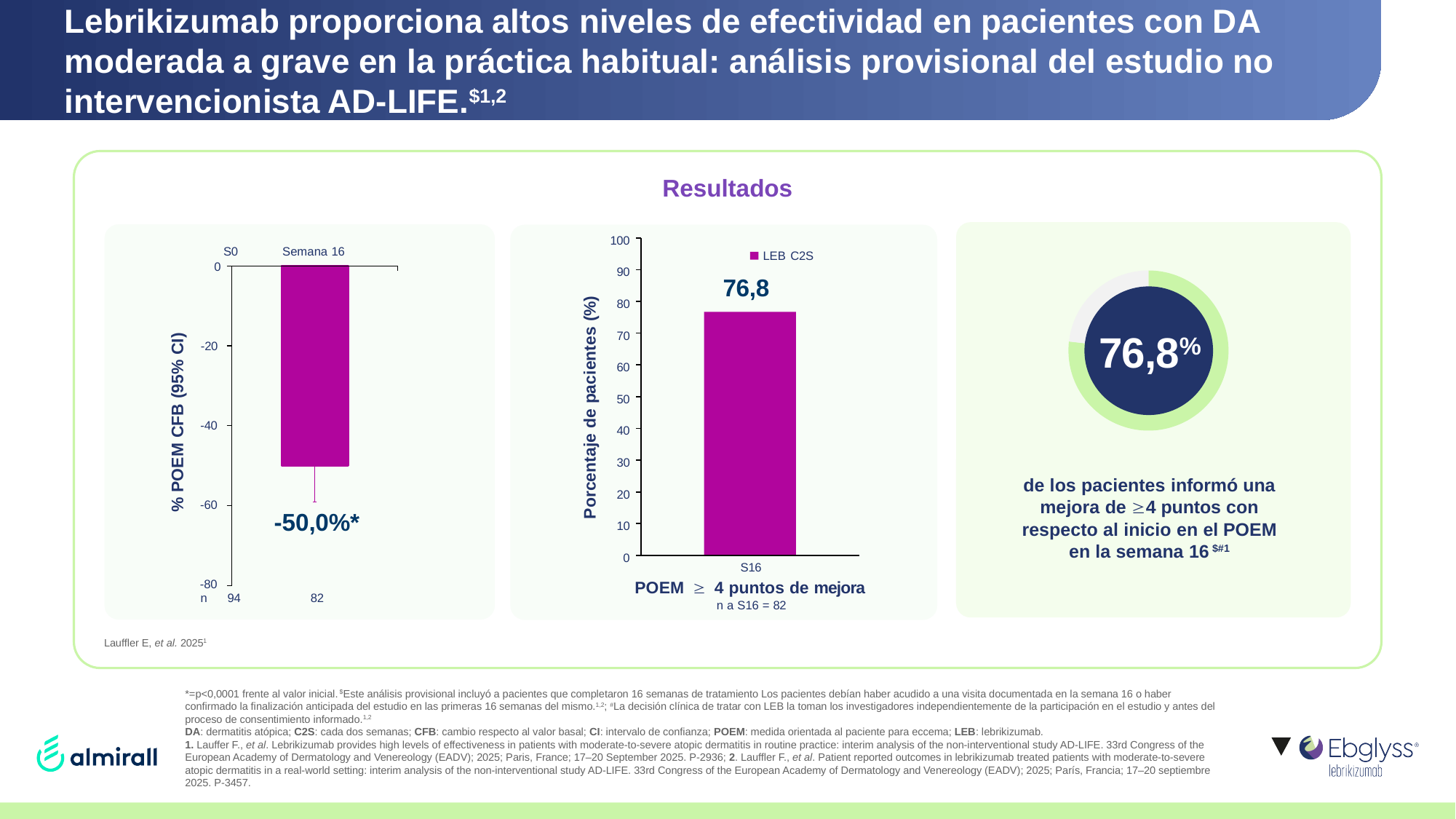
How many series does the legend of the right chart (Porcentaje de pacientes) list? 1 In the left chart (% POEM CFB), what is the value shown for Semana 16? -50,0% What is the legend entry in the right chart (Porcentaje de pacientes)? LEB C2S In the left chart (% POEM CFB), what is the n value shown under S0? 94 What kind of chart is the right chart (Porcentaje de pacientes)? bar chart In the right bar chart (Porcentaje de pacientes), what is the value shown for S16? 76,8 What kind of chart is the left chart (% POEM CFB)? bar chart What is the y-axis title of the left chart? % POEM CFB (95% CI) How many bars are plotted in the left chart (% POEM CFB)? 1 In the right chart (Porcentaje de pacientes), is the value for S16 greater or less than 70? greater In the left chart (% POEM CFB), what is the n value shown under Semana 16? 82 In the left chart (% POEM CFB), is the value for Semana 16 greater or less than -40? less